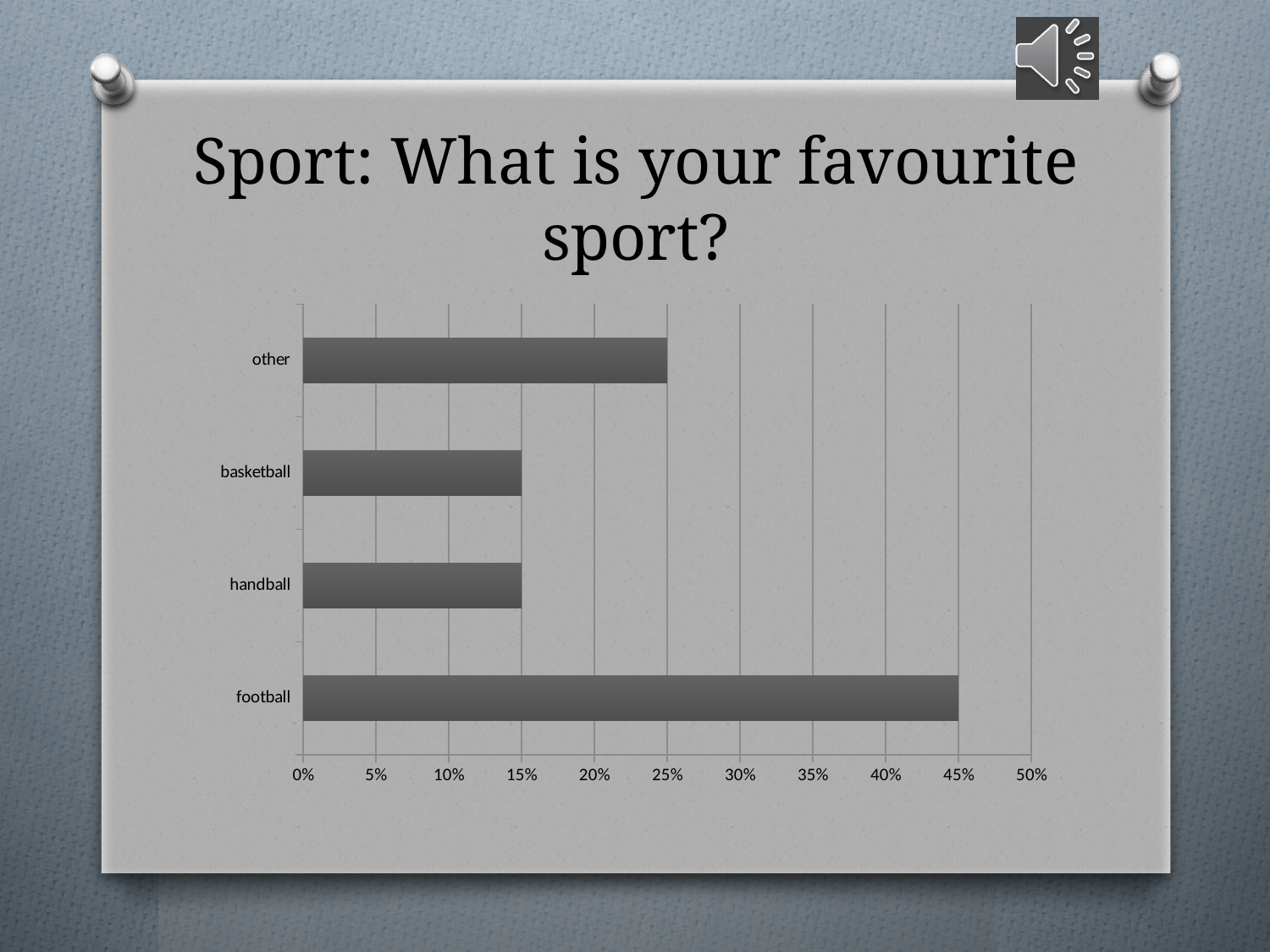
What is the value for basketball? 15% What is the value for other? 25% Which is larger, the value for football or the value for other? football What is the value for handball? 15% Is the value for basketball greater or less than 20%? less What is the title of the chart on the slide? Sport: What is your favourite sport? Is the value for football greater or less than 40%? greater Which sport has the highest value in the chart? football How many sport categories are plotted in the chart? 4 What kind of chart is shown on the slide? bar chart What is the difference between the value for football and the value for other? 20% What is the value for football? 45%